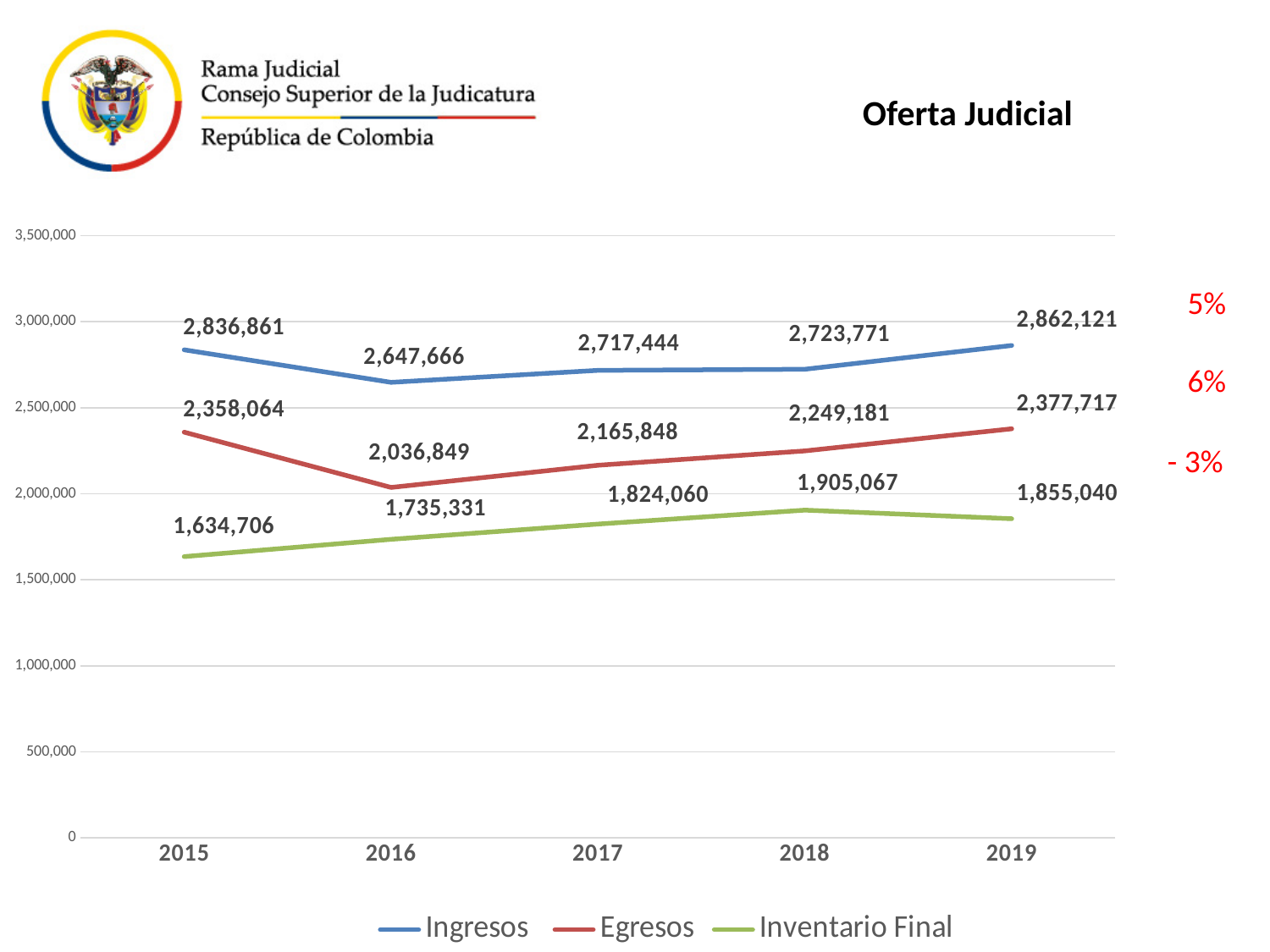
In which year is Egresos lowest? 2016 In which year is Inventario Final highest? 2018 What is the difference between Ingresos and Egresos in 2019? 484,404 How many series does the legend list? 3 What is the value of Egresos in 2016? 2,036,849 Is the value of Inventario Final in 2015 greater or less than 2,000,000? less Which is larger in 2016, Ingresos or Egresos? Ingresos By how much did Inventario Final increase from 2015 to 2018? 270,361 What is the value of Ingresos in 2019? 2,862,121 What kind of chart is shown on the slide? Line chart In which year is Ingresos highest? 2019 What is the value of Inventario Final in 2017? 1,824,060